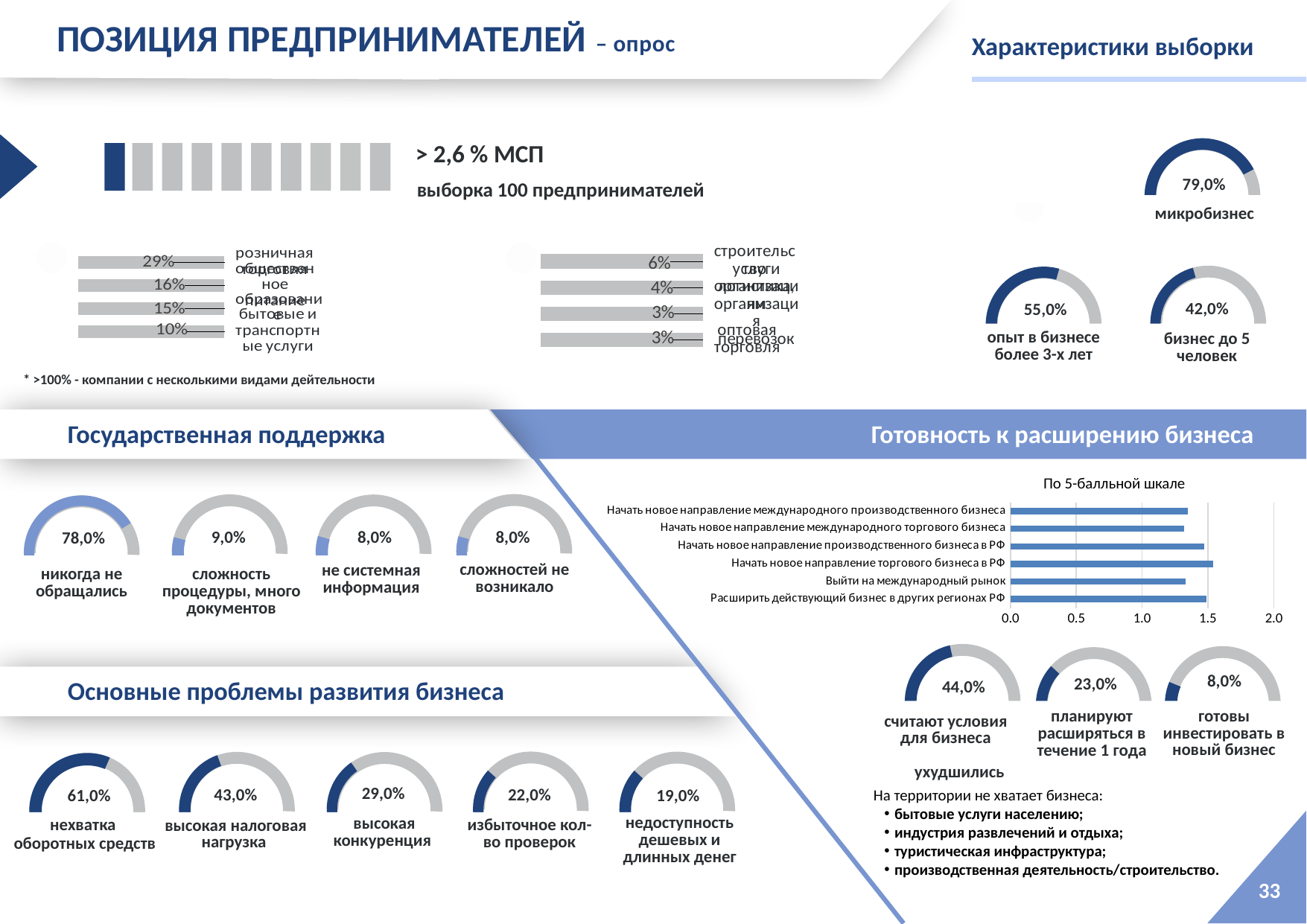
In the 'По 5-балльной шкале' bar chart, is the value for 'Начать новое направление международного торгового бизнеса' greater or less than 1.5? less In the 'Основные проблемы развития бизнеса' section, which problem has the highest percentage? нехватка оборотных средств In the 'Готовность к расширению бизнеса' section, what percentage are готовы инвестировать в новый бизнес? 8,0% On the 'Характеристики выборки' gauges, what percentage have опыт в бизнесе более 3-х лет? 55,0% In the 'Готовность к расширению бизнеса' section, how many categories does the 'По 5-балльной шкале' bar chart show? 6 In the 'Основные проблемы развития бизнеса' section, what is the difference between 'нехватка оборотных средств' and 'высокая налоговая нагрузка'? 18,0% In the 'Основные проблемы развития бизнеса' section, which is larger: 'высокая конкуренция' or 'избыточное кол-во проверок'? высокая конкуренция In the 'Основные проблемы развития бизнеса' section, which problem has the lowest percentage? недоступность дешевых и длинных денег In the 'Государственная поддержка' section, what percentage of respondents никогда не обращались? 78,0% On the 'Характеристики выборки' gauges, what share of the sample is микробизнес? 79,0% In the 'Готовность к расширению бизнеса' section, what type of chart is the 'По 5-балльной шкале' chart? bar chart In the 'Готовность к расширению бизнеса' section, what percentage планируют расширяться в течение 1 года? 23,0%